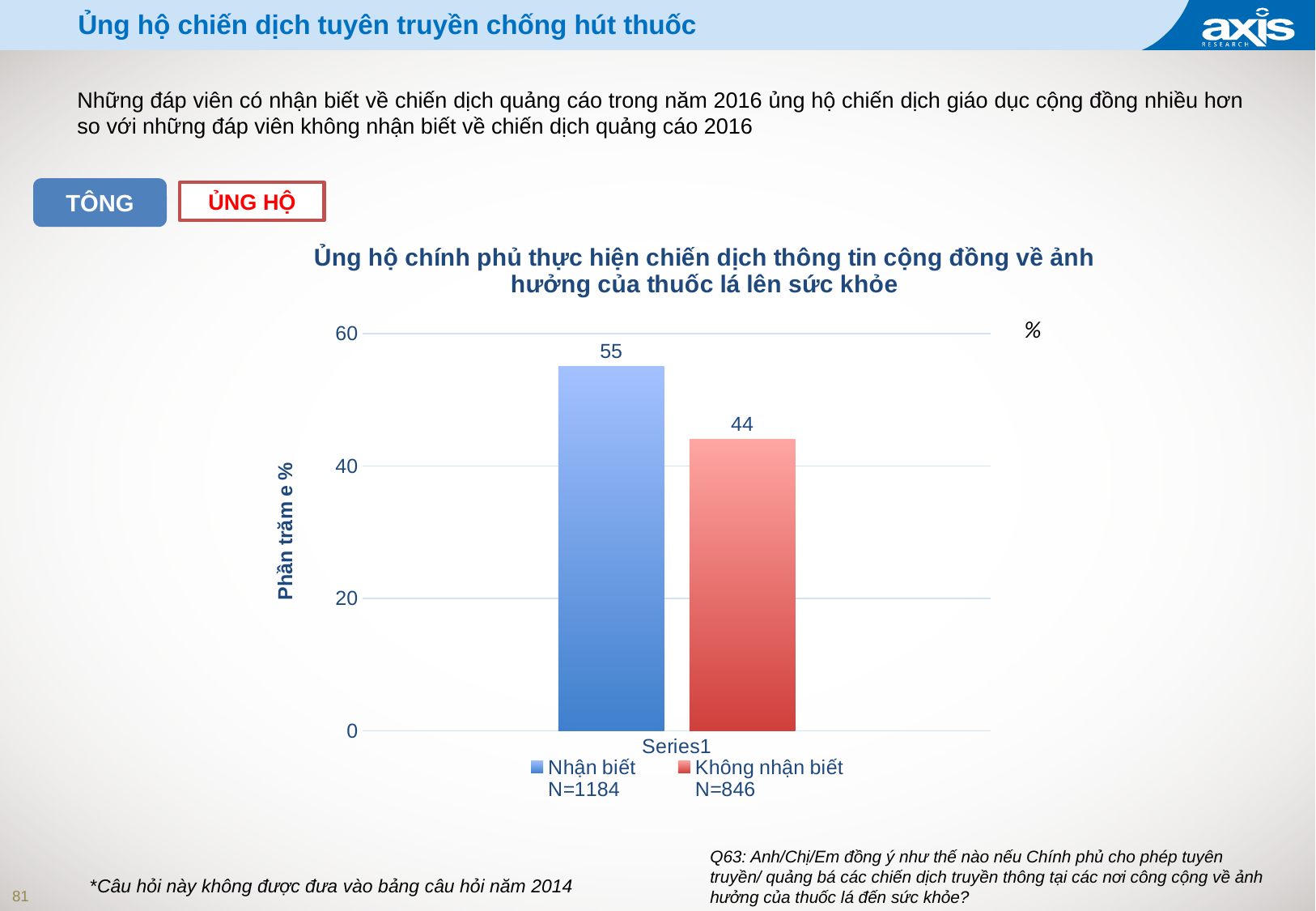
What is the value for Không nhận biết? 44 Which series has the lowest value? Không nhận biết What is the label on the vertical axis? Phần trăm e % Is the value for Không nhận biết greater or less than 40? greater Is the value for Nhận biết greater or less than 60? less Which series has the higher value, Nhận biết or Không nhận biết? Nhận biết What is the sample size (N) shown for Nhận biết in the legend? N=1184 What kind of chart is shown? bar chart What is the value for Nhận biết? 55 What is the difference between the values for Nhận biết and Không nhận biết? 11 How many series does the legend list? 2